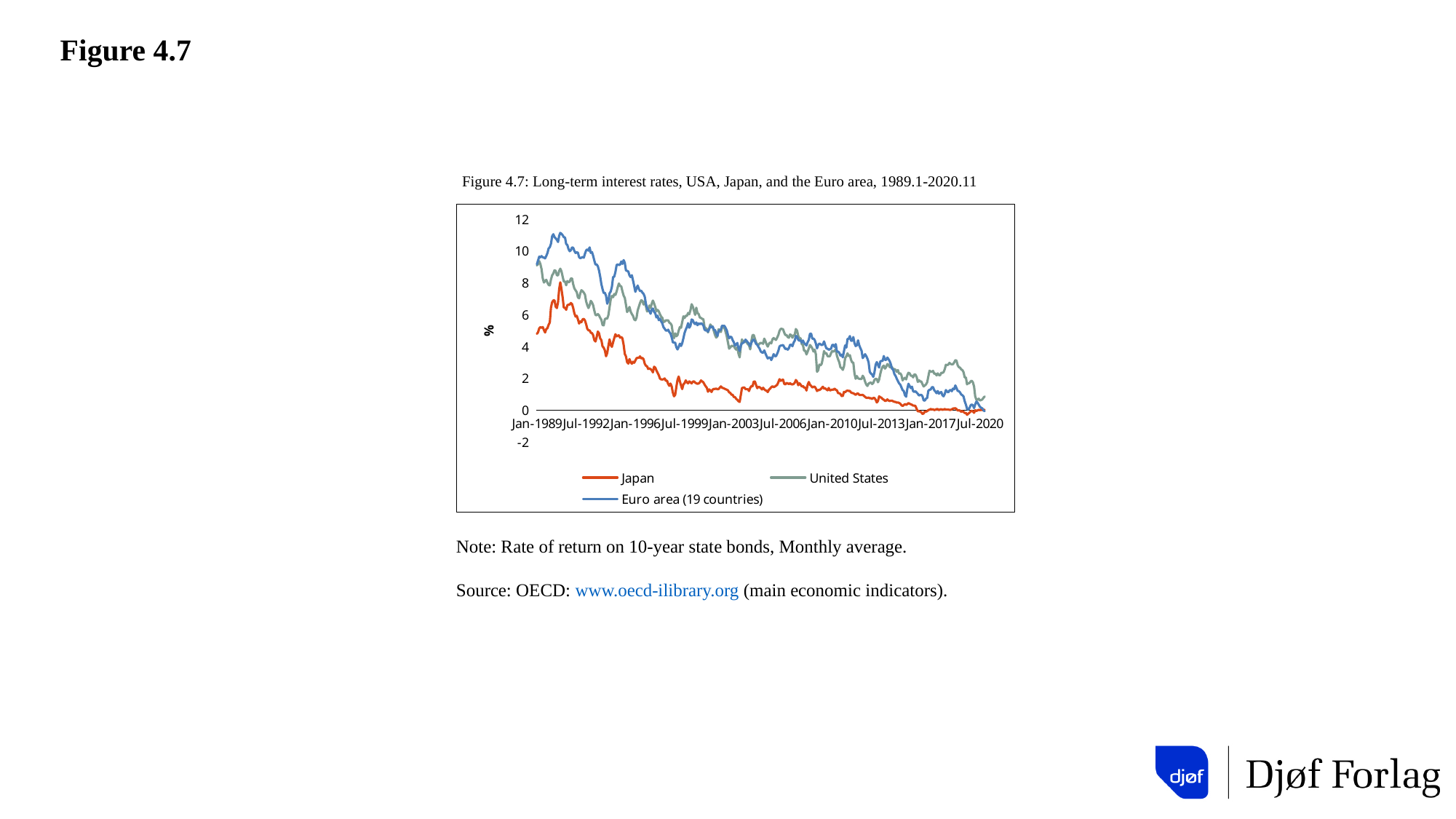
Does the Japan series rise or fall overall from Jan-1989 to Jul-2020? Fall What is the label on the vertical axis? % Which series is the lowest for most of the period shown? Japan Is the peak value of the Euro area (19 countries) series greater or less than 10? greater How many series does the legend list? 3 What is the title of the chart? Figure 4.7: Long-term interest rates, USA, Japan, and the Euro area, 1989.1-2020.11 Is the value for Japan at Jul-2020 greater or less than 2? less Is the value for the United States at Jan-1989 greater or less than 8? greater Does the United States series rise or fall overall across the period shown? Fall Which series reaches the highest peak on the chart? Euro area (19 countries) What kind of chart is shown on the slide? Line chart At Jul-1992, which is larger: the Euro area (19 countries) value or the Japan value? Euro area (19 countries)